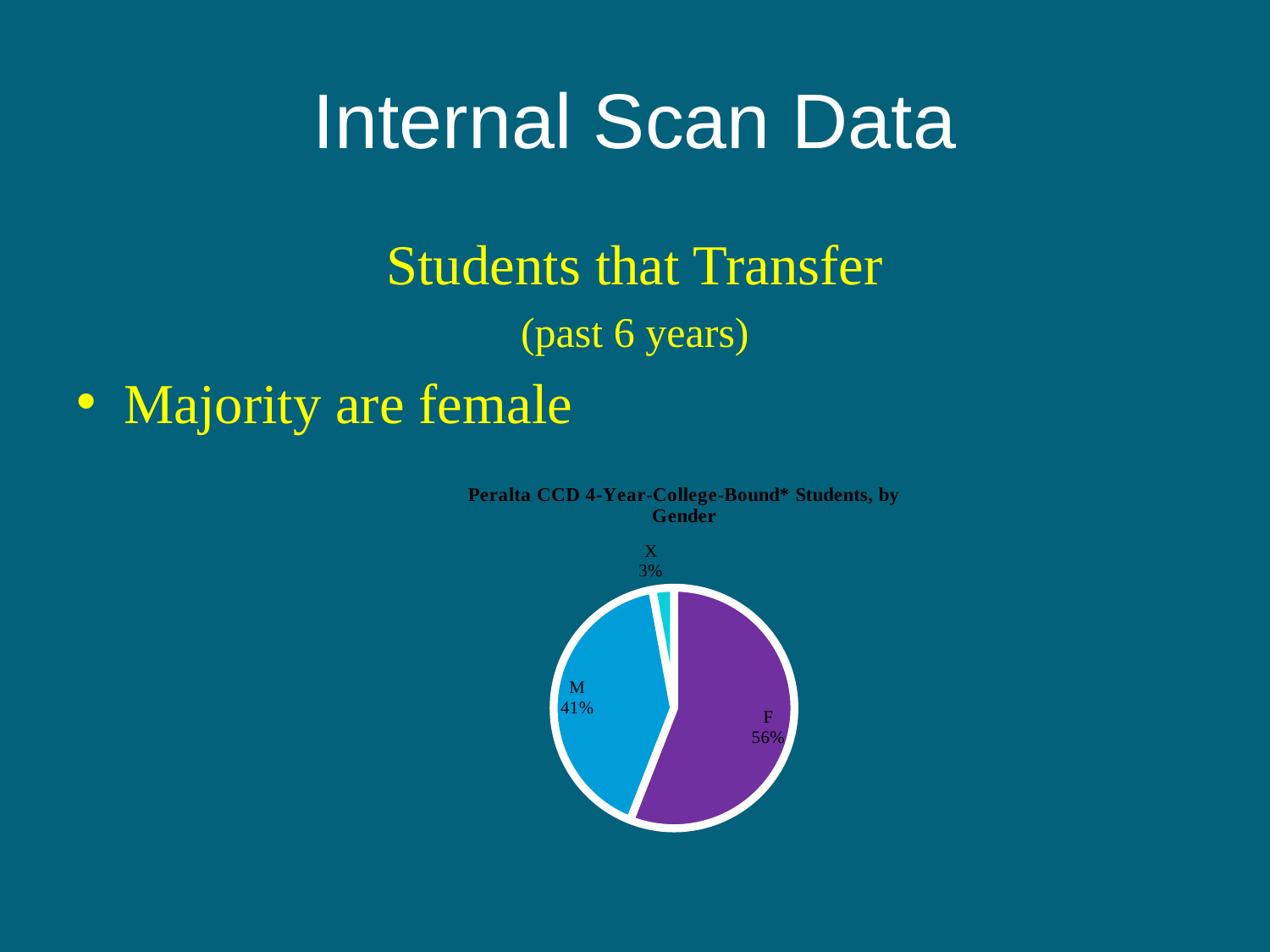
What colour is the F slice of the pie? purple What is the difference in percentage points between the F and M slices? 15 What percentage of the pie is labelled M? 41% Which category has the largest share of the pie? F What is the combined share of the M and X slices? 44% What percentage of the pie is labelled F? 56% What type of chart is shown on the slide? pie chart Which category has the smallest share of the pie? X What is the title of the chart? Peralta CCD 4-Year-College-Bound* Students, by Gender What percentage of the pie is labelled X? 3% Which slice is larger, M or X? M How many slices does the pie chart have? 3